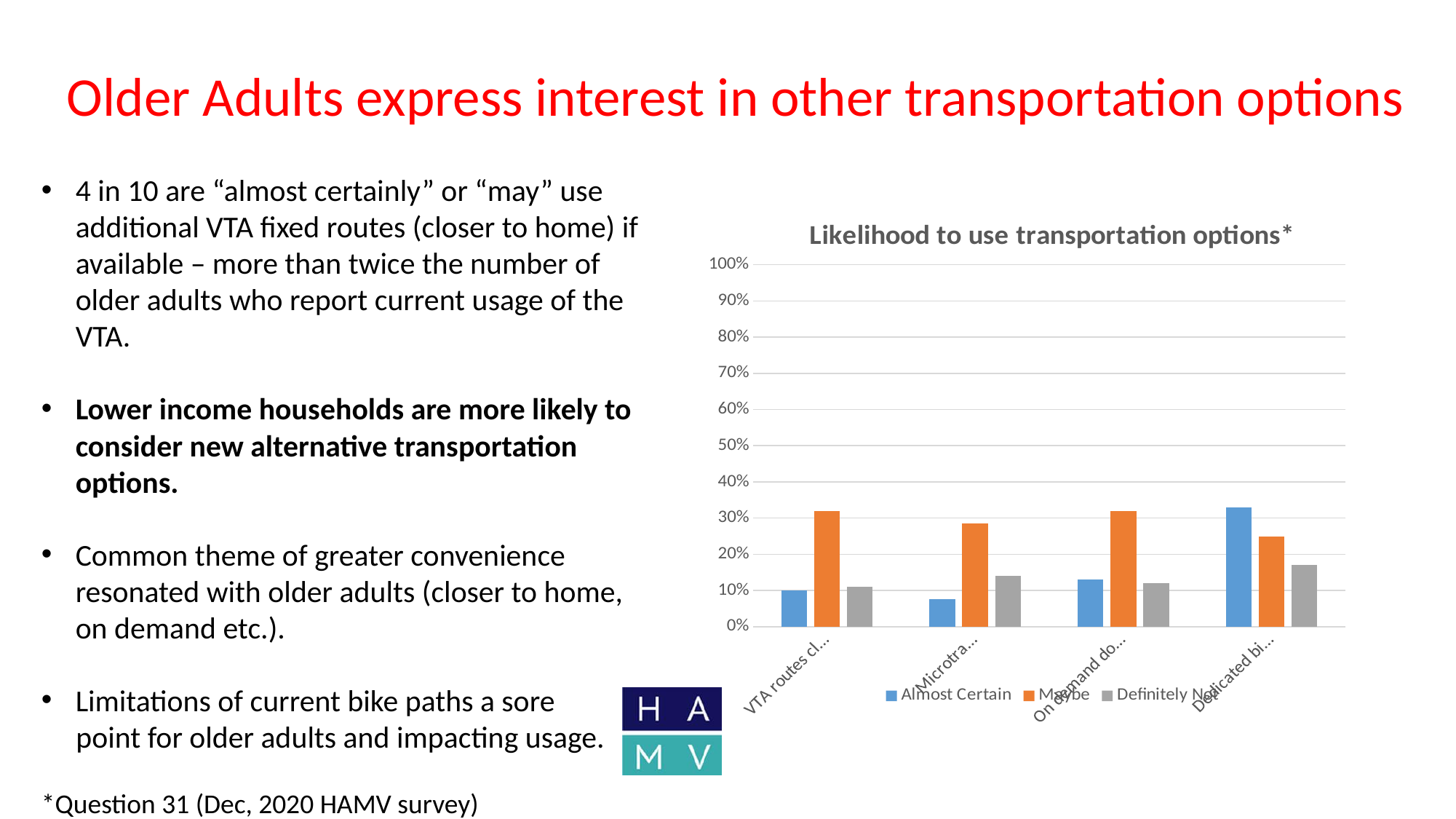
Is the 'Almost Certain' value for the fourth category ('Dedicated bi...') greater or less than 30%? greater Which category has the highest 'Almost Certain' bar? Dedicated bi... (the fourth category) Is the 'Almost Certain' value for the second category ('Microtra...') greater or less than 10%? less What kind of chart is shown on the slide? bar chart How many categories are plotted along the x axis of the chart? 4 Is the 'Maybe' value for the second category ('Microtra...') greater or less than 20%? greater How many series does the chart legend list? 3 What is the title of the chart? Likelihood to use transportation options* For the fourth category ('Dedicated bi...'), which is larger: 'Almost Certain' or 'Maybe'? Almost Certain Which category has the lowest 'Almost Certain' bar? Microtra... (the second category) For the first category ('VTA routes cl...'), which is larger: 'Almost Certain' or 'Maybe'? Maybe